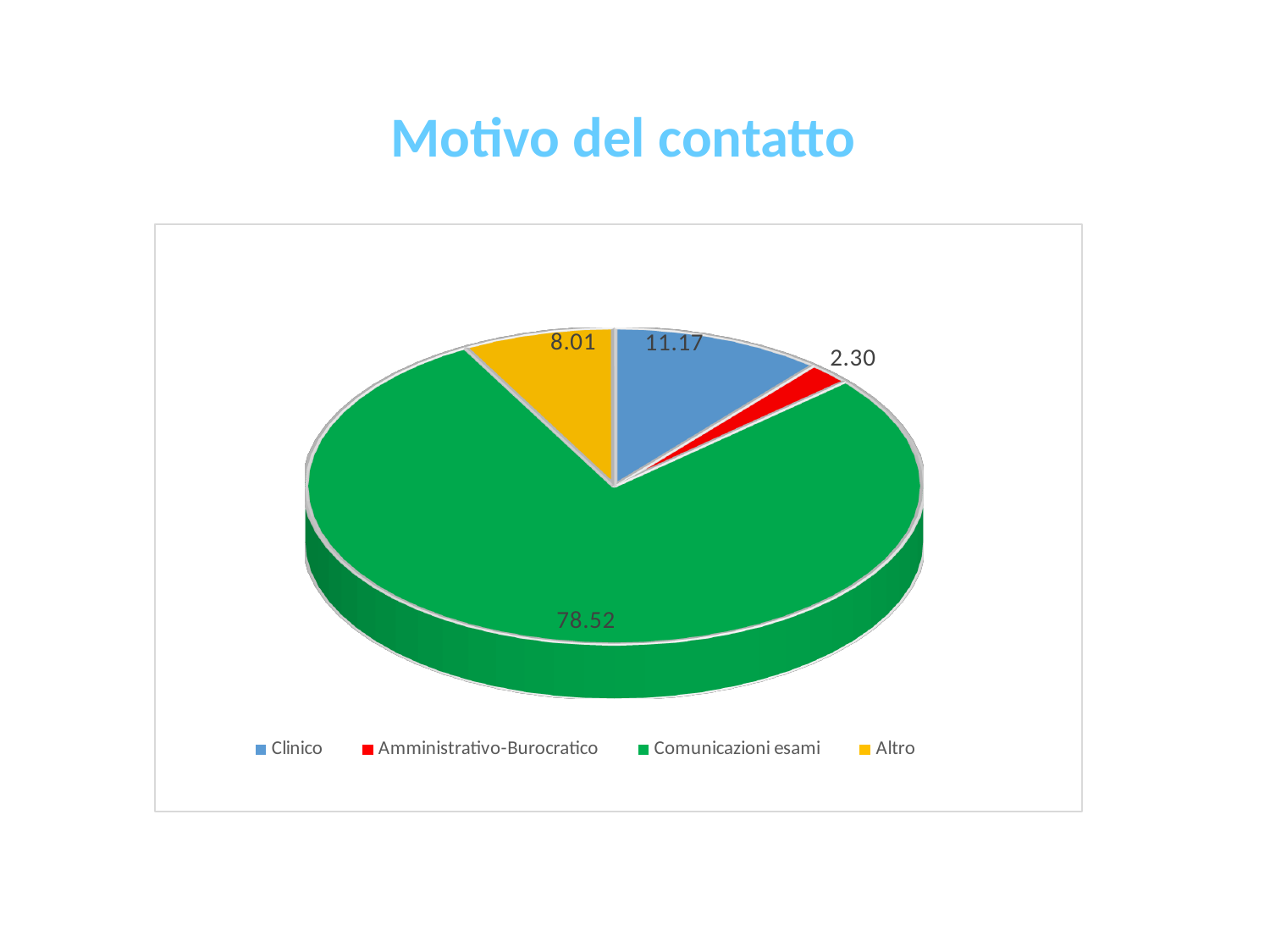
What is the value for Amministrativo-Burocratico? 2.30 What is the value for Comunicazioni esami? 78.52 What is the title of the slide? Motivo del contatto What kind of chart is shown on the slide? pie chart How many categories does the pie chart have? 4 What is the value for Altro? 8.01 What colour is the slice for Comunicazioni esami? green Which is larger, the value for Clinico or the value for Altro? Clinico What is the difference between the values for Clinico and Altro? 3.16 Which category has the smallest slice? Amministrativo-Burocratico What is the value for Clinico? 11.17 Which category has the largest slice? Comunicazioni esami